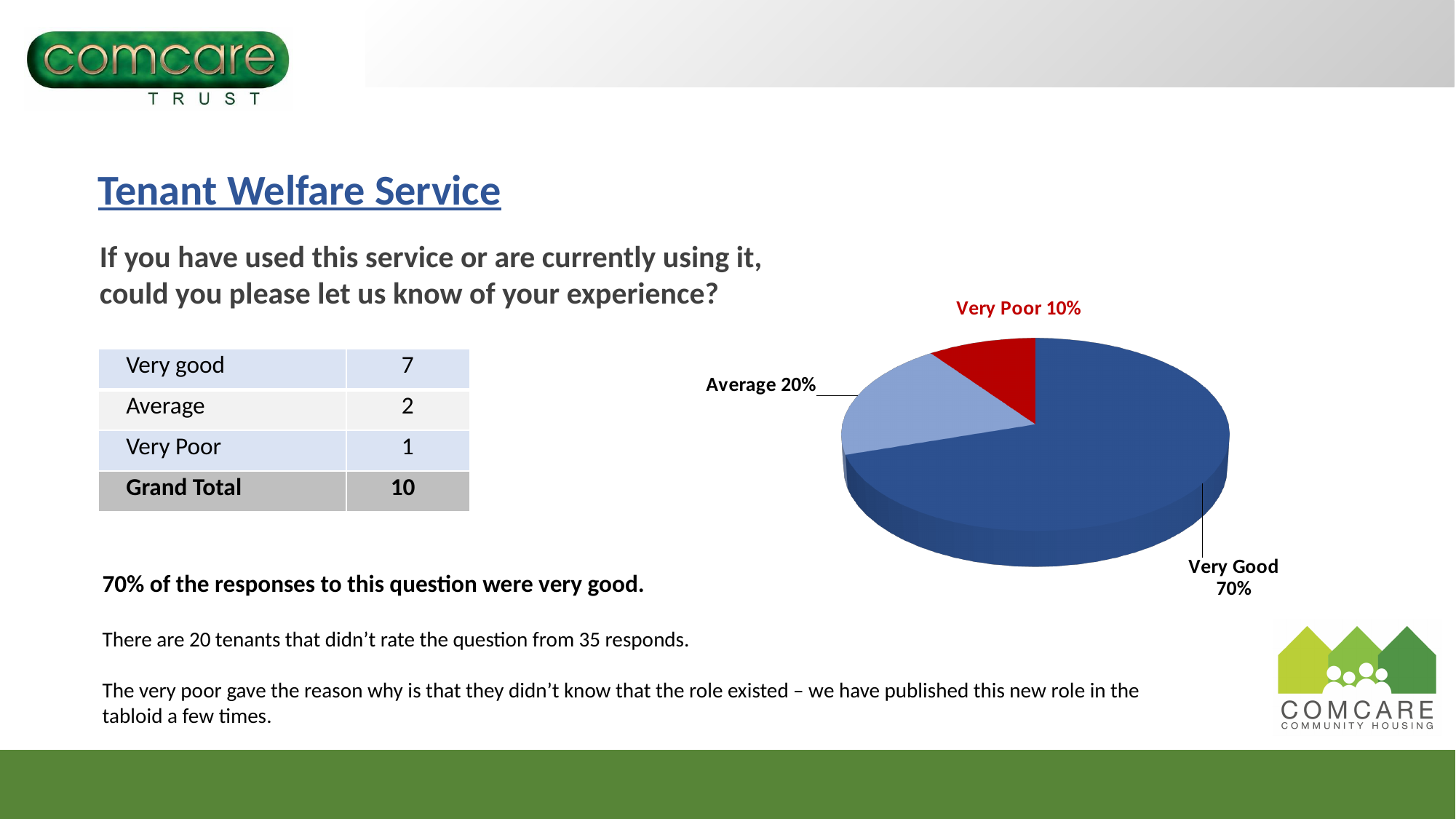
Is the Very Good slice greater or less than 50% of the pie? greater Which category has the largest slice of the pie? Very Good How many slices does the pie chart have? 3 What is the difference in percentage points between the Very Good and Average slices? 50% Which category has the smallest slice of the pie? Very Poor What share of the pie does Very Poor represent? 10% What share of the pie does Average represent? 20% Which slice is larger, Average or Very Poor? Average What share of the pie does Very Good represent? 70% What colour is the Very Poor slice of the pie? Red What kind of chart is shown on the slide? Pie chart What is the difference in percentage points between the Average and Very Poor slices? 10%